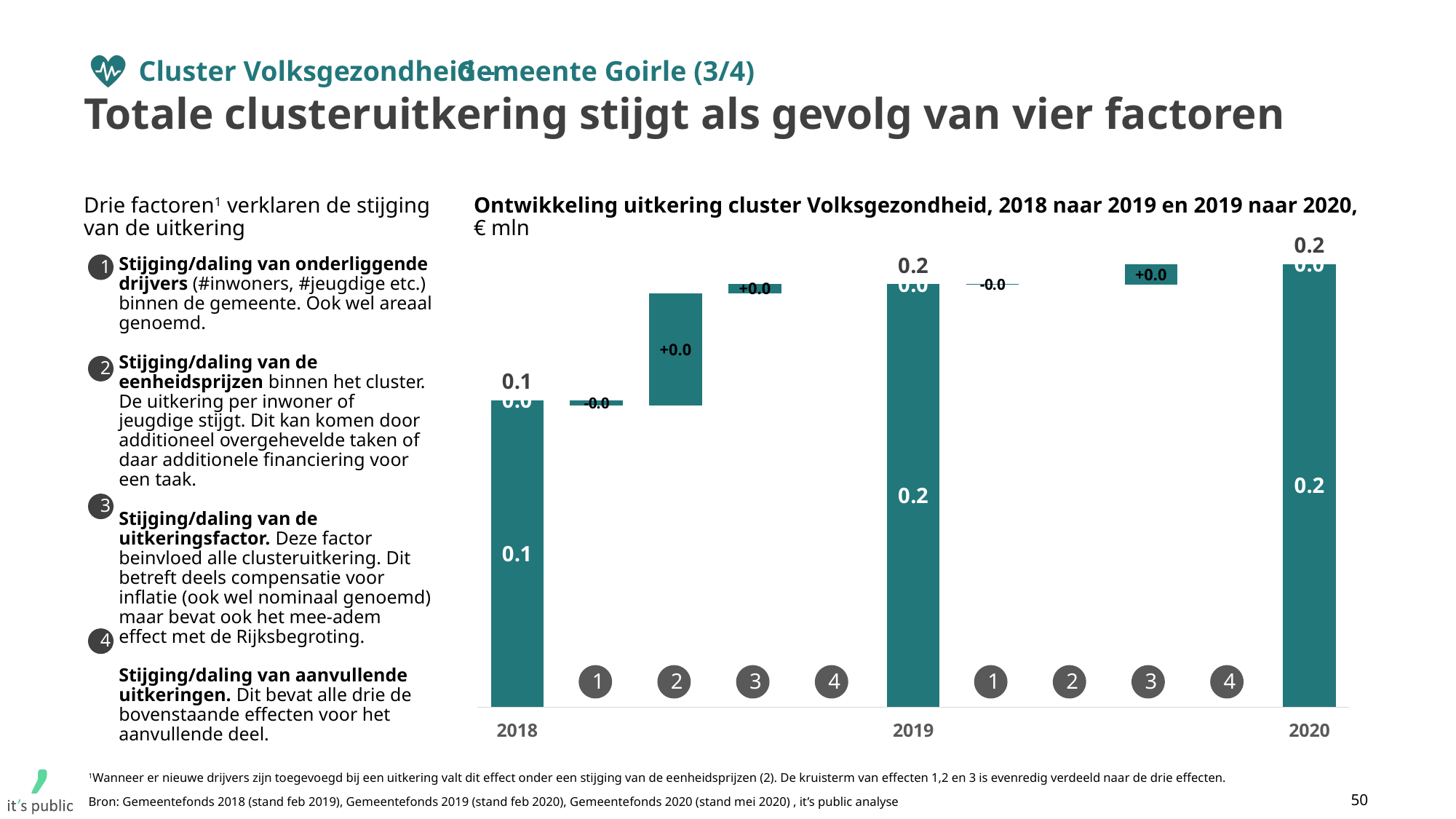
What is the total uitkering value shown for 2020? 0.2 Which is larger, the total for 2018 or the total for 2019? 2019 What is the total uitkering value shown for 2019? 0.2 What unit is stated under the chart title? € mln What kind of chart is shown on the slide? bar chart What is the difference between the 2019 total and the 2018 total? 0.1 What is the label on the factor 1 bar between 2018 and 2019? -0.0 Do the year totals rise or fall from 2018 to 2020? rise What is the label on the factor 2 bar between 2018 and 2019? +0.0 Which year has the lowest total uitkering value in the chart? 2018 What is the total uitkering value shown for 2018? 0.1 How many year totals (2018, 2019, 2020) are shown in the chart? 3